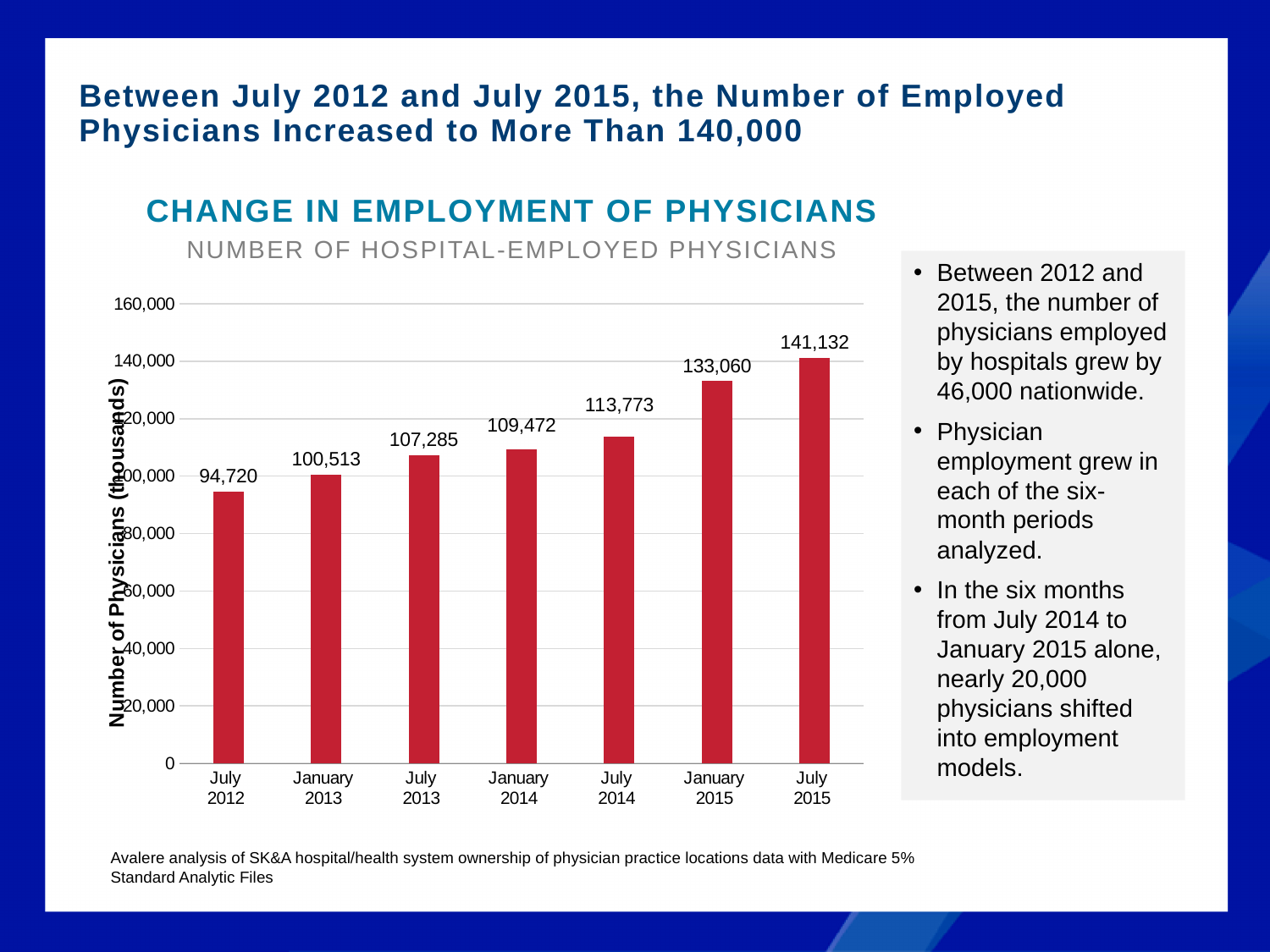
Which period has the lowest number of hospital-employed physicians? July 2012 Do the values rise or fall from July 2012 to July 2015? Rise What is the number of hospital-employed physicians in July 2012? 94,720 What kind of chart is shown on the slide? Bar chart What is the difference between the number of physicians in July 2015 and July 2012? 46,412 How many periods are shown on the x axis of the chart? 7 Is the value for July 2015 greater or less than 140,000? greater What is the difference between the number of physicians in January 2015 and July 2014? 19,287 Which period has the highest number of hospital-employed physicians? July 2015 What is the number of hospital-employed physicians in July 2014? 113,773 Which is larger, the value for January 2014 or the value for July 2013? January 2014 What is the number of hospital-employed physicians in January 2015? 133,060